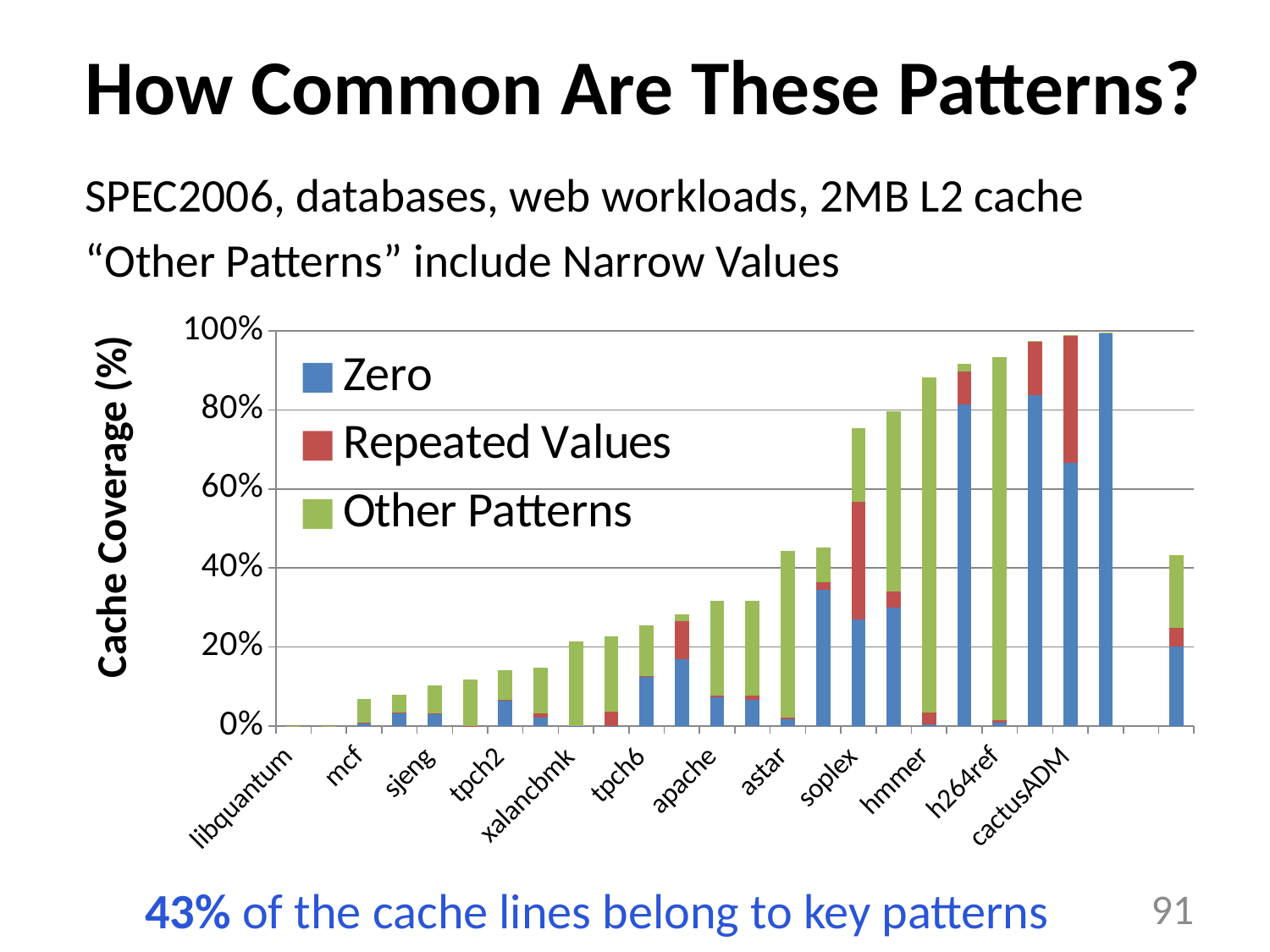
Do the total bar heights generally rise or fall from left to right across the benchmarks? rise Is the total cache coverage for soplex greater or less than 60%? greater What are the three series named in the legend? Zero, Repeated Values, Other Patterns Is the total cache coverage for apache greater or less than 40%? less What is the label of the vertical axis? Cache Coverage (%) Is the total cache coverage for hmmer greater or less than 80%? greater Which labeled benchmark has the lowest total cache coverage? libquantum What kind of chart is shown on the slide? stacked bar chart How many series does the chart's legend list? 3